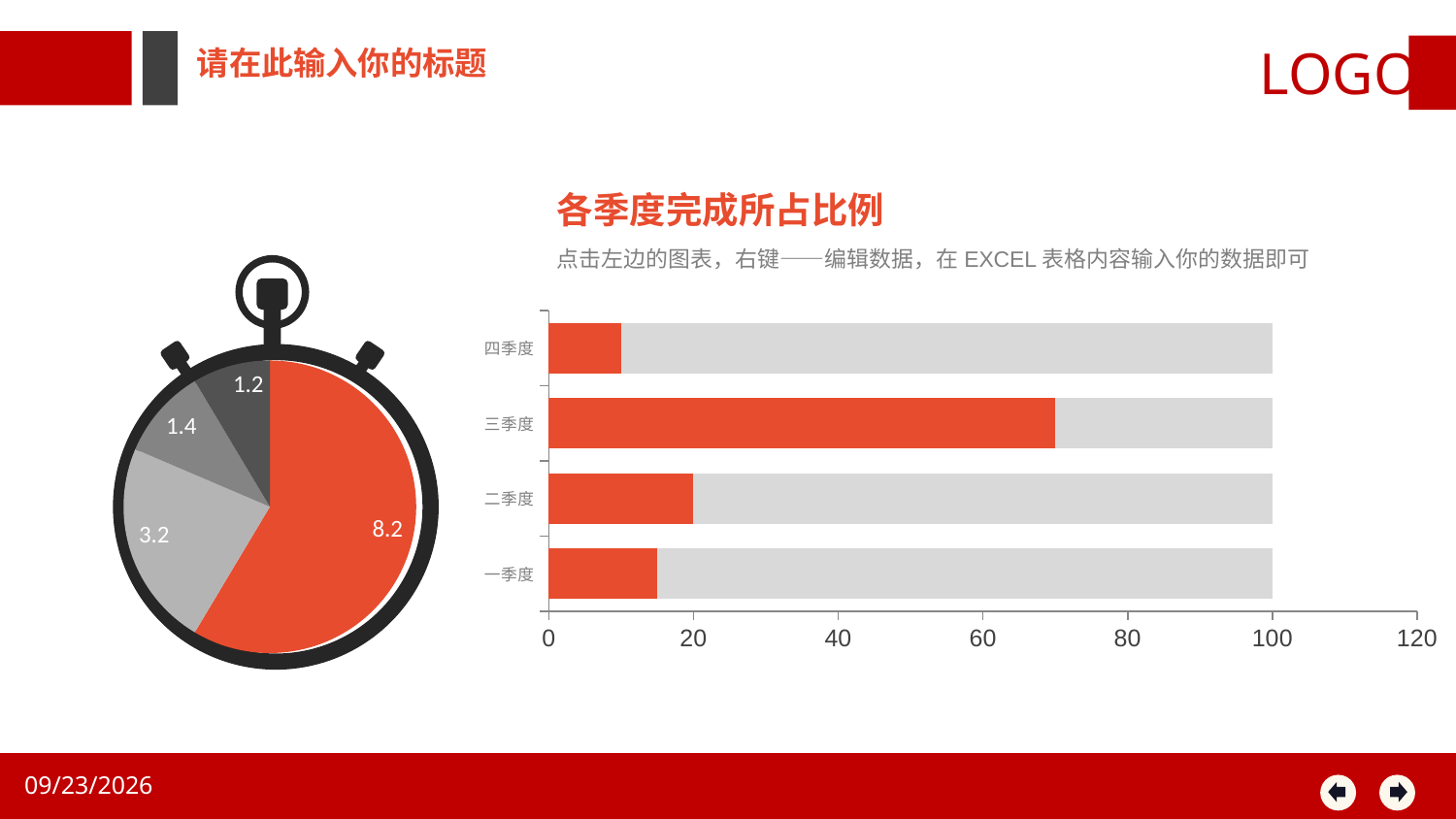
In the bar chart titled 各季度完成所占比例, which has the longer orange bar, 三季度 or 二季度? 三季度 In the bar chart titled 各季度完成所占比例, is the orange bar for 四季度 greater or less than 20? less In the bar chart titled 各季度完成所占比例, is the orange bar for 一季度 greater or less than 20? less In the bar chart titled 各季度完成所占比例, how many quarter categories are shown? 4 In the bar chart titled 各季度完成所占比例, which quarter has the shortest orange bar? 四季度 In the pie chart inside the stopwatch on the left, what is the value of the smallest slice? 1.2 In the pie chart inside the stopwatch on the left, how many slices are there? 4 In the pie chart inside the stopwatch on the left, what is the difference between the largest slice (8.2) and the smallest slice (1.2)? 7.0 In the bar chart titled 各季度完成所占比例, is the orange bar for 三季度 greater or less than 60? greater In the bar chart titled 各季度完成所占比例, which quarter has the longest orange bar? 三季度 In the pie chart inside the stopwatch on the left, what is the value of the largest slice? 8.2 What kind of chart is the chart on the right titled 各季度完成所占比例? bar chart